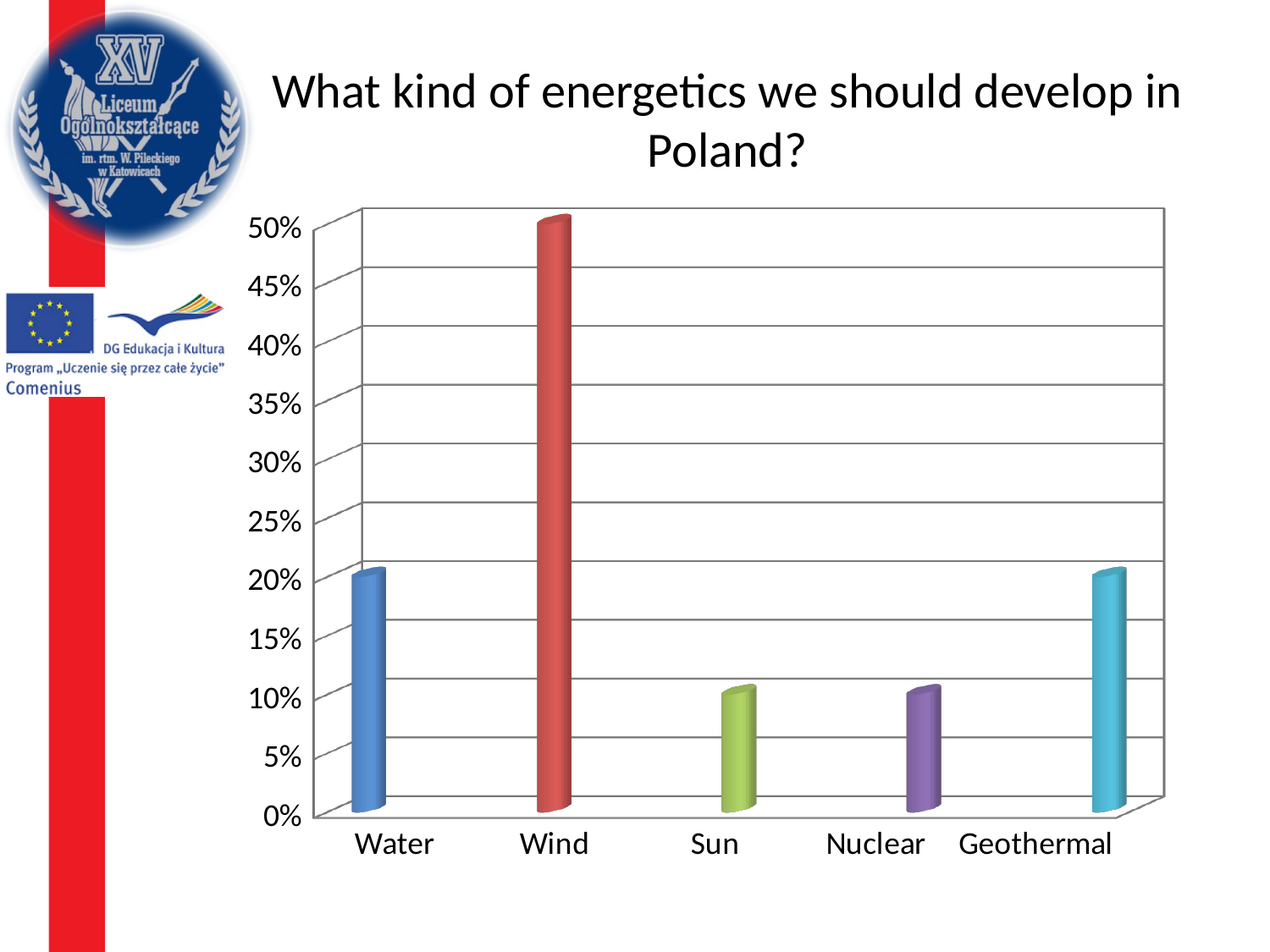
How many categories are shown on the x axis of the chart? 5 What is the value for Wind? 50% What is the value for Geothermal? 20% What is the value for Sun? 10% What is the title of the chart on the slide? What kind of energetics we should develop in Poland? Is the value for Nuclear greater or less than 25%? less What is the value for Water? 20% Which category has the highest value in the chart? Wind Which is larger, the value for Water or the value for Sun? Water What type of chart is shown on the slide? bar chart Is the value for Wind greater or less than 40%? greater What is the difference between the value for Wind and the value for Water? 30%